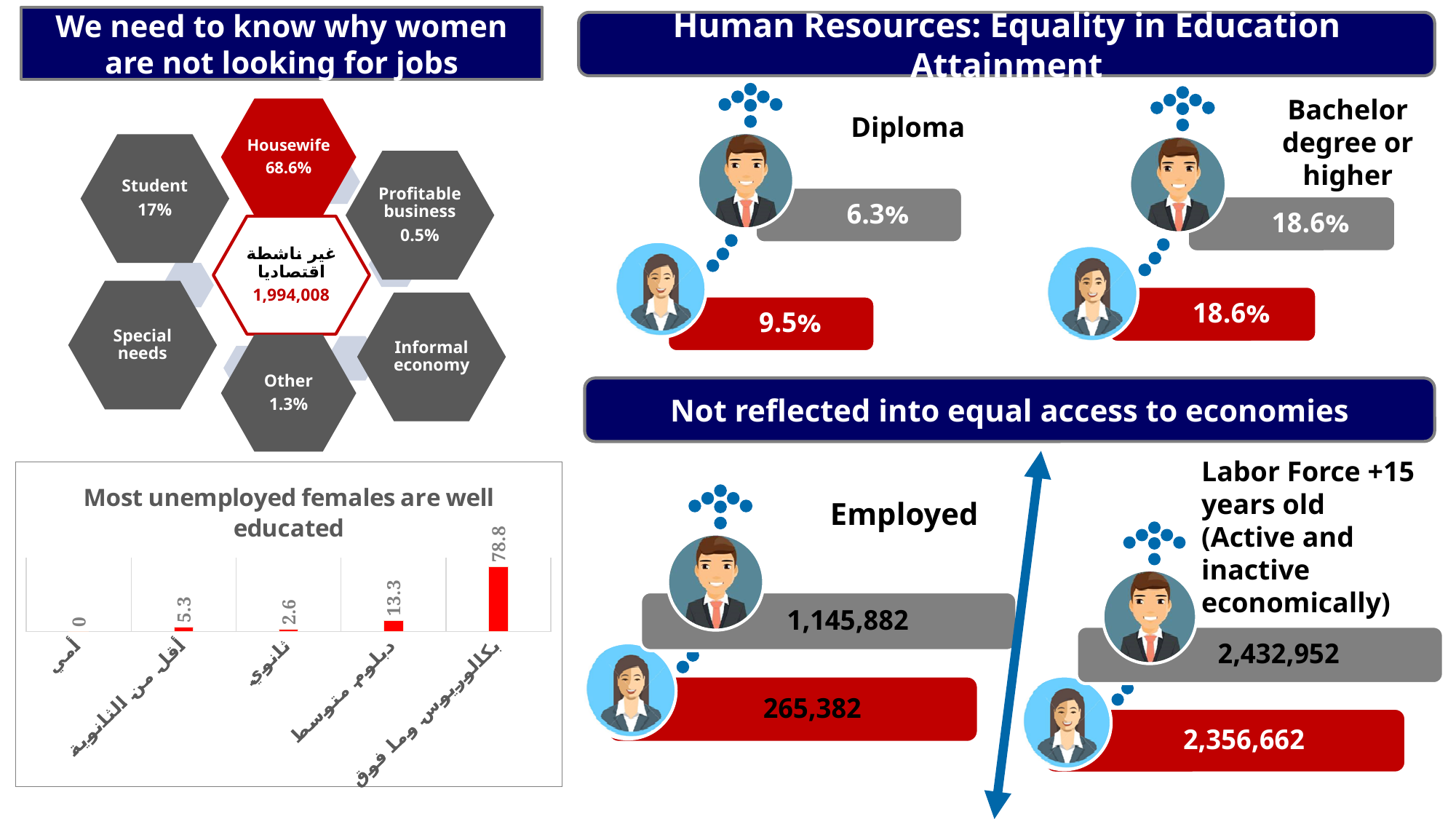
In the chart titled "Most unemployed females are well educated", what is the value for دبلوم متوسط? 13.3 In the chart titled "Most unemployed females are well educated", what is the value for أمي? 0 In the chart titled "Most unemployed females are well educated", what is the value for ثانوي? 2.6 In the chart titled "Most unemployed females are well educated", which is larger: the value for أقل من الثانوية or the value for ثانوي? أقل من الثانوية In the chart titled "Most unemployed females are well educated", which category has the lowest value? أمي What kind of chart is the one titled "Most unemployed females are well educated"? Bar chart In the chart titled "Most unemployed females are well educated", what is the value for أقل من الثانوية? 5.3 In the chart titled "Most unemployed females are well educated", what is the value for بكالوريوس وما فوق? 78.8 How many categories are shown in the chart titled "Most unemployed females are well educated"? 5 In the chart titled "Most unemployed females are well educated", which category has the highest value? بكالوريوس وما فوق In the chart titled "Most unemployed females are well educated", what is the difference between the values for بكالوريوس وما فوق and دبلوم متوسط? 65.5 What colour are the bars in the chart titled "Most unemployed females are well educated"? Red